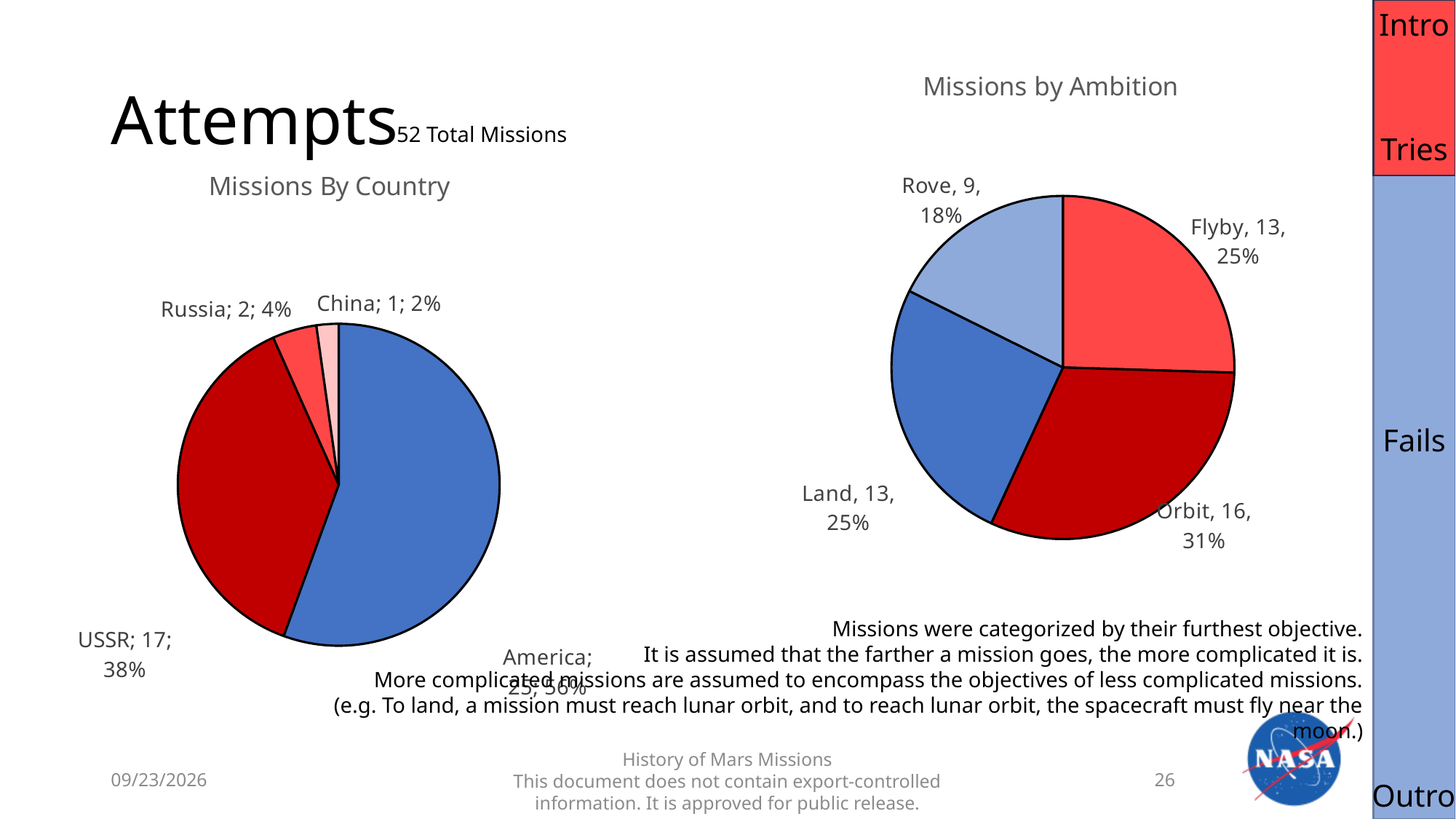
In the Missions by Ambition chart, what share of missions does the Rove slice represent? 18% In the Missions by Ambition chart, how many missions are in the Orbit category? 16 In the Missions By Country chart, which country has the largest slice? America How many categories are shown in the Missions by Ambition chart? 4 In the Missions By Country chart, how many missions are attributed to the USSR? 17 In the Missions by Ambition chart, which category has the smallest slice? Rove What kind of chart is the Missions by Ambition chart? Pie chart In the Missions By Country chart, how many more missions does the USSR have than Russia? 15 In the Missions By Country chart, what share of missions does the USSR slice represent? 38% In the Missions by Ambition chart, what is the difference between the Orbit and Rove mission counts? 7 In the Missions By Country chart, how many missions are attributed to Russia? 2 In the Missions By Country chart, which country has the smallest slice? China